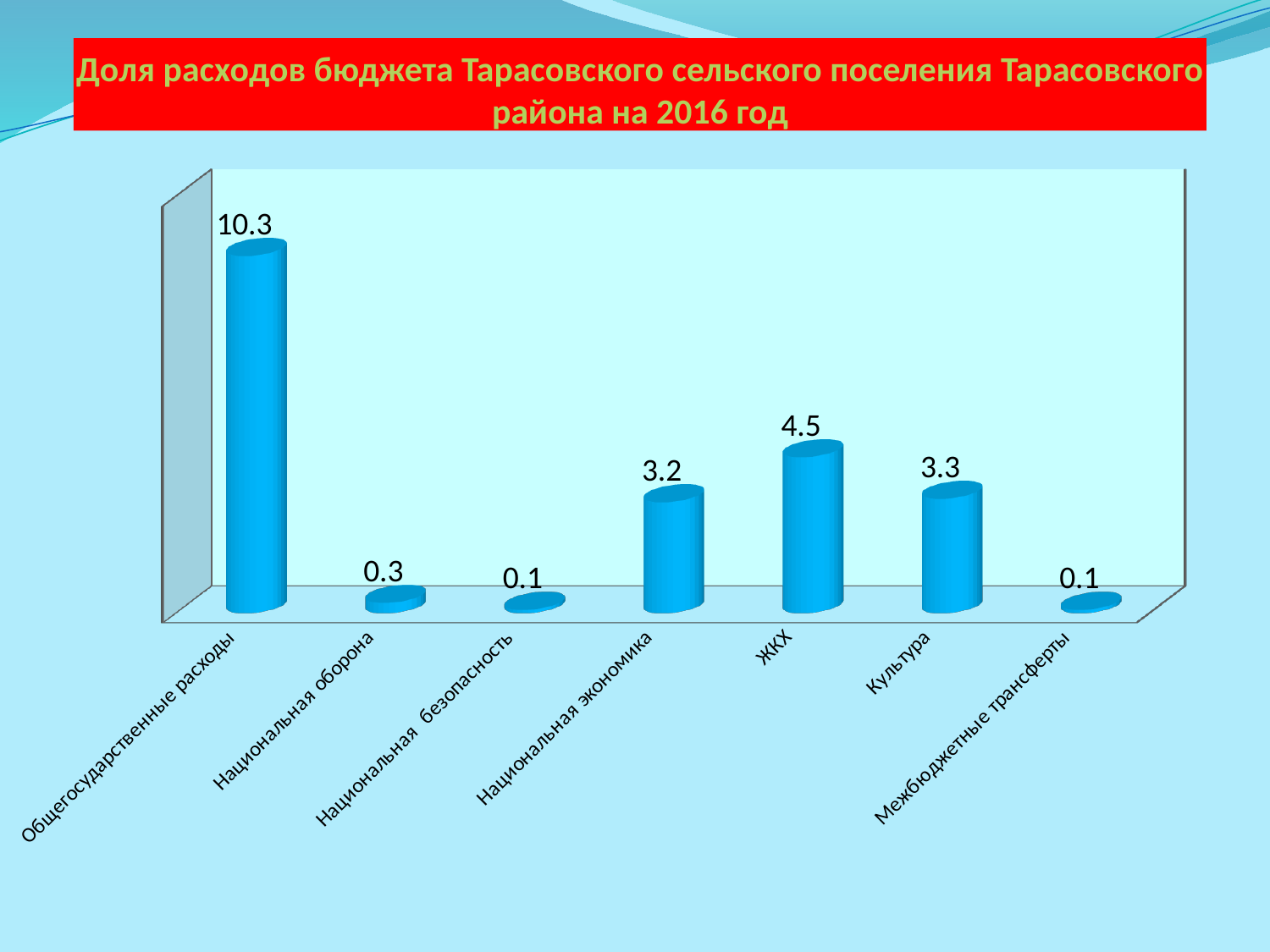
Which is larger, the value for Национальная оборона or the value for Национальная безопасность? Национальная оборона What is the difference between the values for Общегосударственные расходы and ЖКХ? 5.8 Which category has the highest value? Общегосударственные расходы How many categories are shown in the chart? 7 What kind of chart is shown on the slide? Bar chart What is the title of the slide? Доля расходов бюджета Тарасовского сельского поселения Тарасовского района на 2016 год What is the value for ЖКХ? 4.5 What is the value for Общегосударственные расходы? 10.3 What is the difference between the values for ЖКХ and Культура? 1.2 Which is larger, the value for ЖКХ or the value for Национальная экономика? ЖКХ What is the value for Национальная экономика? 3.2 What is the value for Культура? 3.3